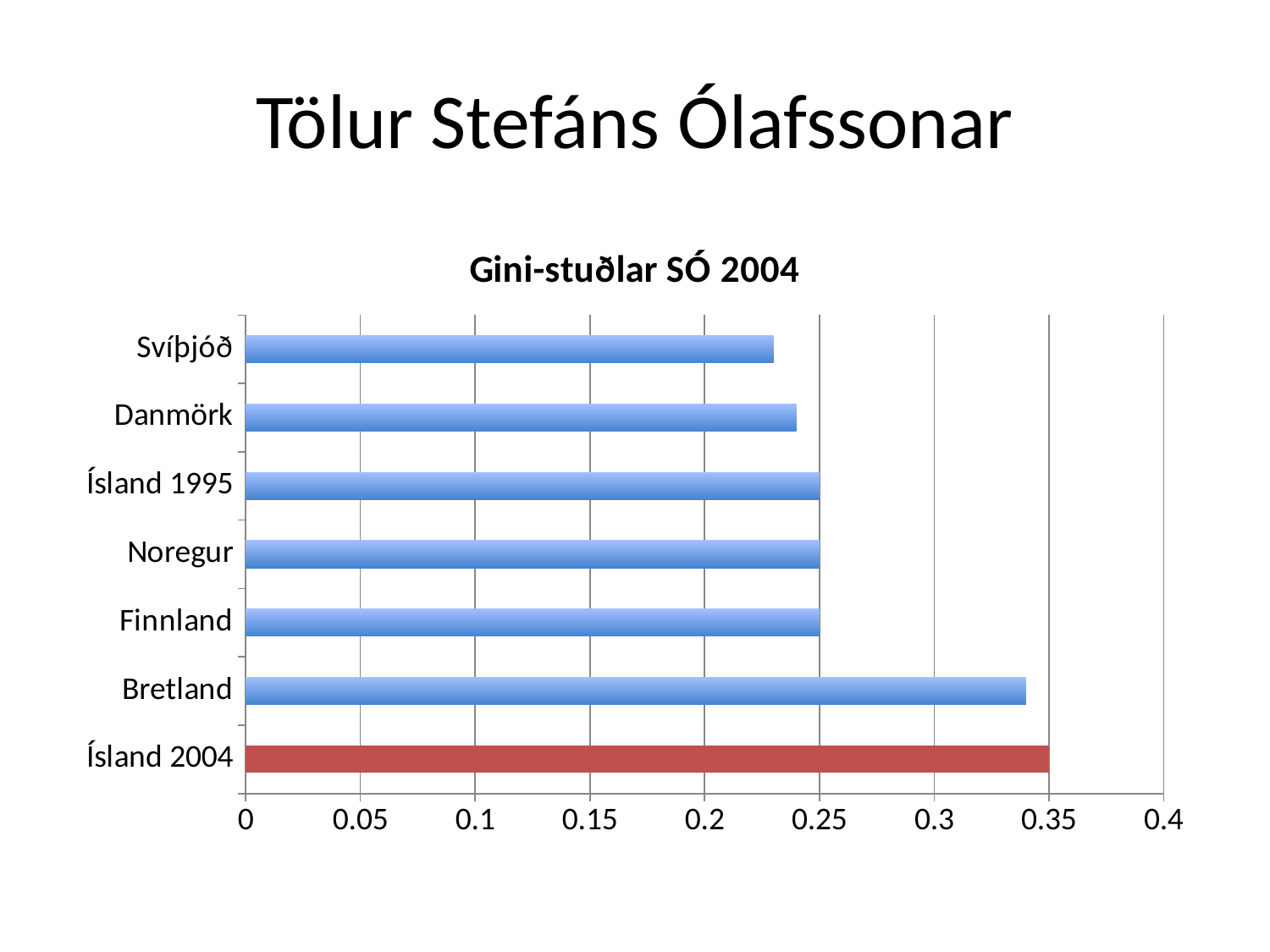
Which category's bar is drawn in a different colour (red) from the others? Ísland 2004 Which is larger, the value for Bretland or the value for Finnland? Bretland Which category has the lowest value? Svíþjóð What kind of chart is shown on the slide? bar chart What is the title of the chart? Gini-stuðlar SÓ 2004 Is the value for Bretland greater or less than 0.3? greater What is the value for Ísland 2004? 0.35 What is the value for Ísland 1995? 0.25 What is the value for Noregur? 0.25 What is the difference between the values for Ísland 2004 and Ísland 1995? 0.1 Which category has the highest value? Ísland 2004 How many categories are plotted in the chart? 7